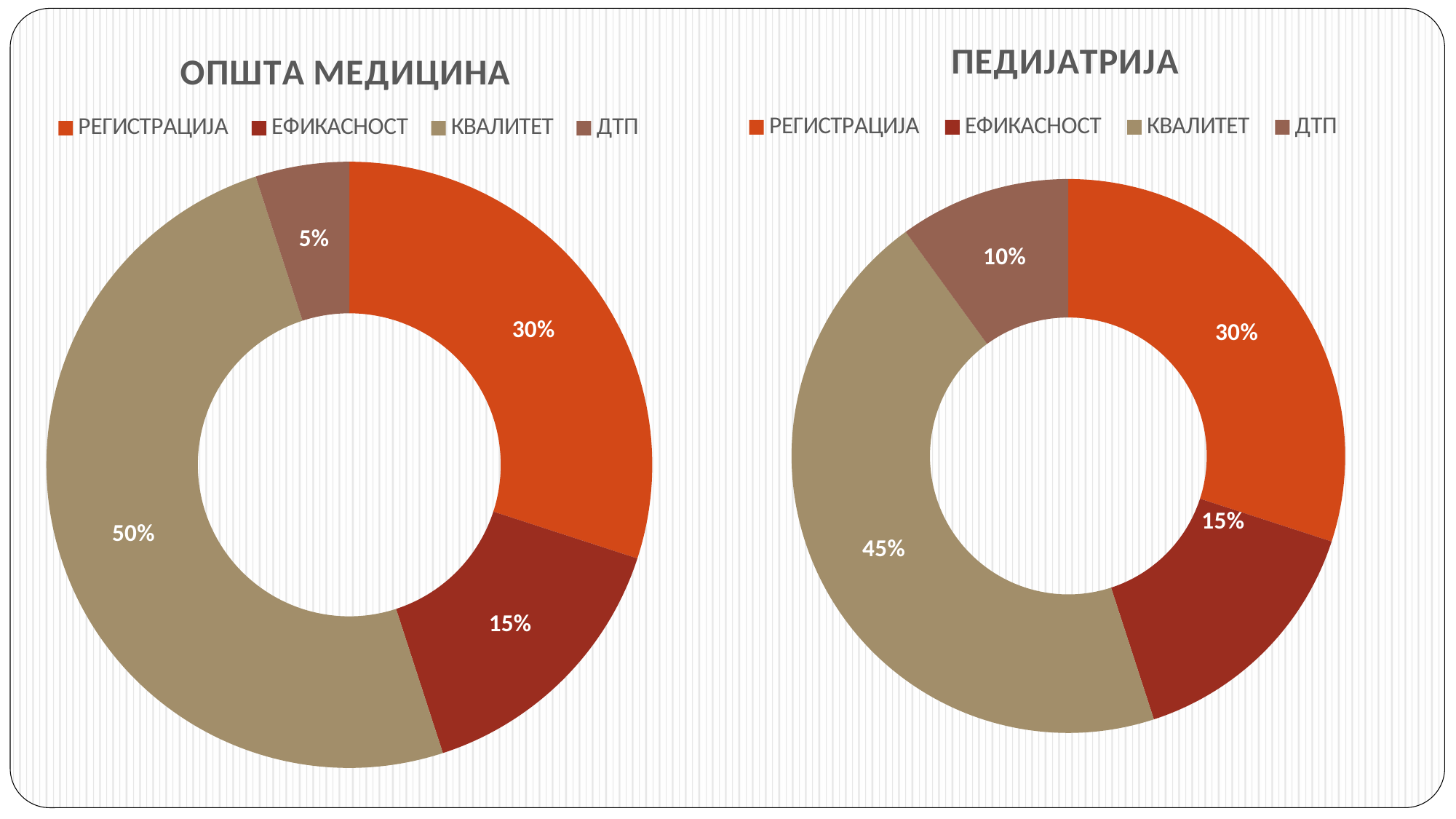
In the ПЕДИЈАТРИЈА chart, which category has the largest share? КВАЛИТЕТ How many categories does the ПЕДИЈАТРИЈА chart show? 4 In the ОПШТА МЕДИЦИНА chart, which category has the smallest share? ДТП In the ОПШТА МЕДИЦИНА chart, what is the value for РЕГИСТРАЦИЈА? 30% In the ОПШТА МЕДИЦИНА chart, what is the difference between КВАЛИТЕТ and РЕГИСТРАЦИЈА? 20% In the ПЕДИЈАТРИЈА chart, what share does ДТП have? 10% In the ПЕДИЈАТРИЈА chart, what is the difference between РЕГИСТРАЦИЈА and ЕФИКАСНОСТ? 15% In the ПЕДИЈАТРИЈА chart, what is the value for КВАЛИТЕТ? 45% How many entries does the legend of the ОПШТА МЕДИЦИНА chart list? 4 What type of chart is the ОПШТА МЕДИЦИНА chart? Doughnut chart In the ОПШТА МЕДИЦИНА chart, what share does КВАЛИТЕТ have? 50% Which chart shows a larger share for ДТП, ОПШТА МЕДИЦИНА or ПЕДИЈАТРИЈА? ПЕДИЈАТРИЈА